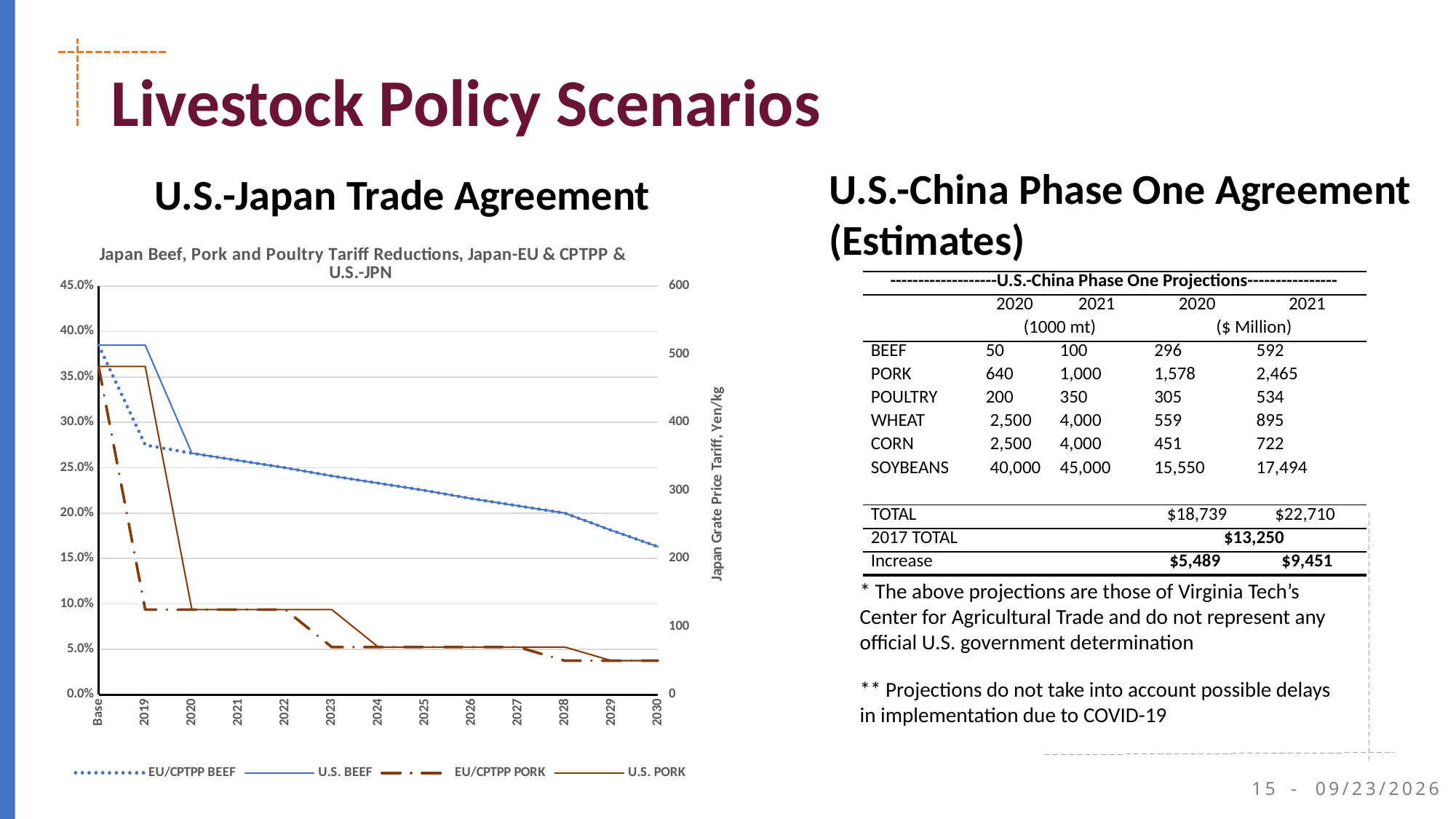
What kind of chart is shown on the slide? line chart How many points are labelled along the x axis of the chart? 13 Is the value for U.S. BEEF in 2020 greater or less than 30.0%? less What is the title of the chart? Japan Beef, Pork and Poultry Tariff Reductions, Japan-EU & CPTPP & U.S.-JPN Does the U.S. BEEF line rise or fall from Base to 2030? fall Which is larger at Base, the U.S. BEEF value or the EU/CPTPP BEEF value? Neither; they are equal Is the value for EU/CPTPP BEEF in 2019 greater or less than 30.0%? less How many series does the chart legend list? 4 Is the value for U.S. BEEF in 2030 greater or less than 20.0%? less What is the label of the right-hand vertical axis of the chart? Japan Grate Price Tariff, Yen/kg